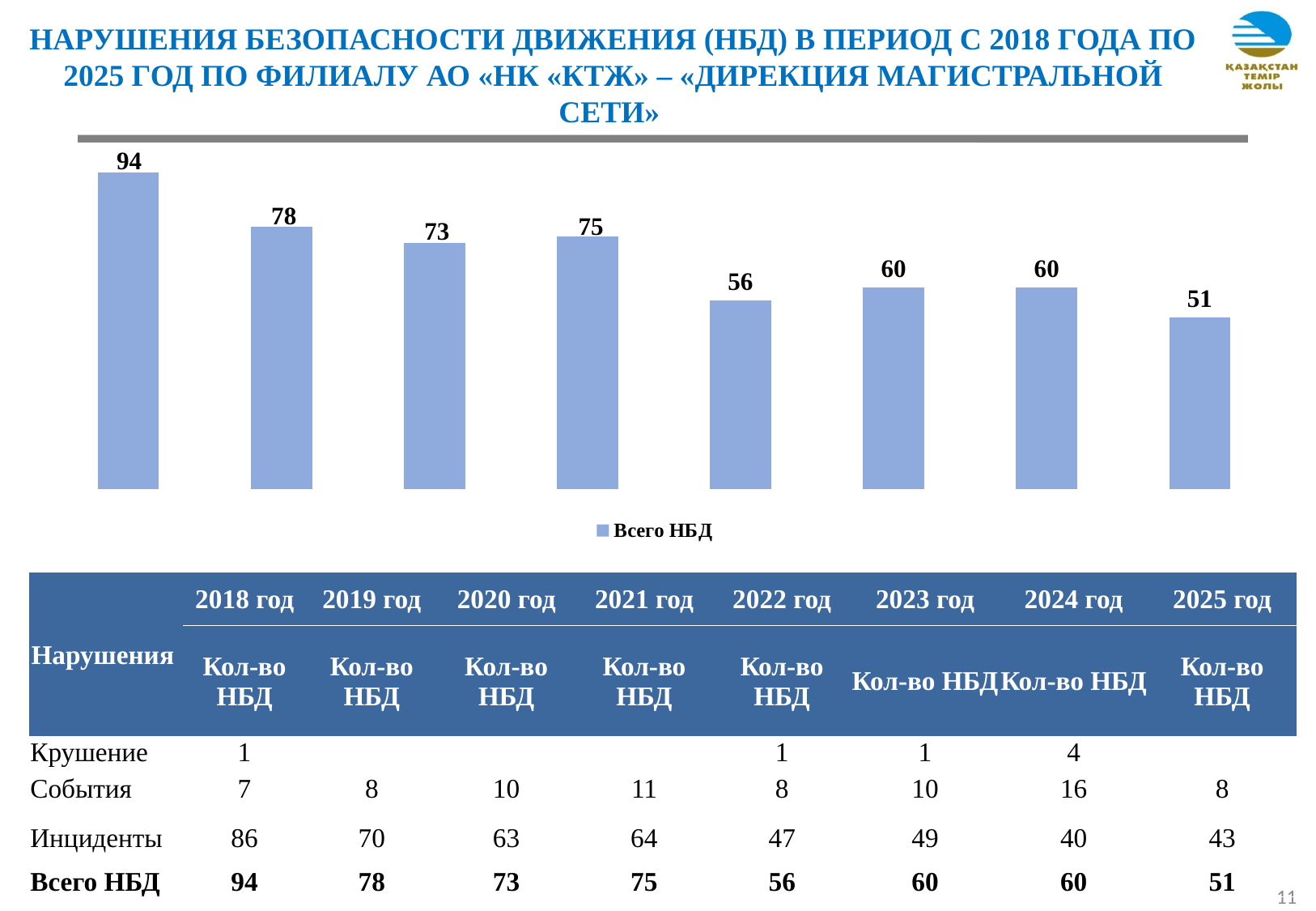
Which bar has the lowest value in the chart? the last bar (2025), 51 Do the values in the chart generally rise or fall from left to right? fall How many series does the chart legend list? 1 What is the value of the fifth bar in the chart, corresponding to 2022? 56 What is the value of the first (leftmost) bar in the chart, corresponding to 2018? 94 What type of chart is shown on the slide? bar chart What is the name of the series shown in the chart legend? Всего НБД Which is larger in the chart: the third bar (2020) or the fourth bar (2021)? the fourth bar (2021), 75 How many bars are plotted in the chart? 8 What is the value of the last (rightmost) bar in the chart, corresponding to 2025? 51 What is the difference between the first bar (94) and the last bar (51) in the chart? 43 Which bar has the highest value in the chart? the first bar (2018), 94